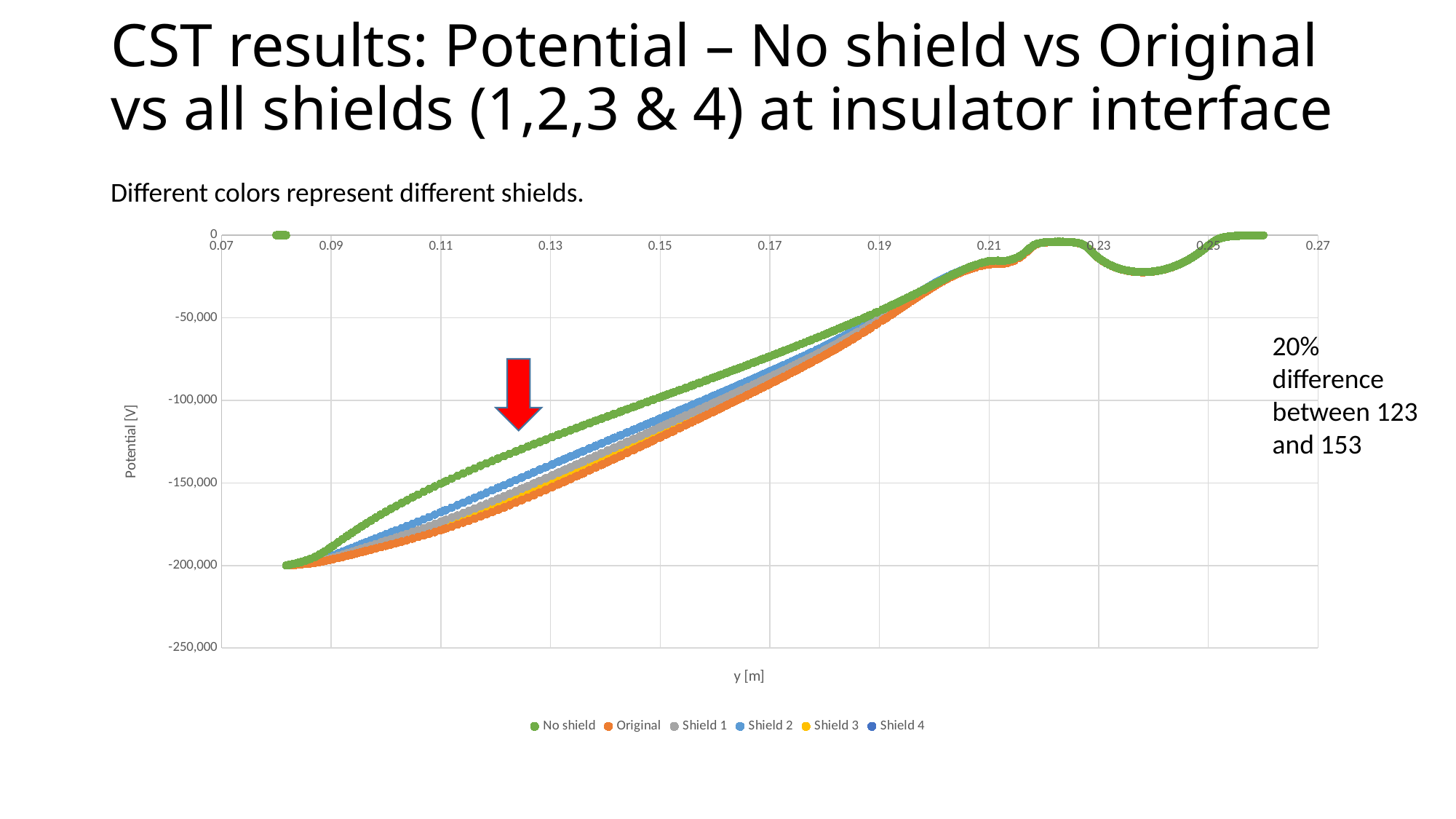
At y = 0.13, which series has the highest potential? No shield At y = 0.13, is the potential for No shield greater or less than -150,000? greater At y = 0.17, is the potential for No shield greater or less than -100,000? greater At y = 0.11, is the potential for Original greater or less than -150,000? less At y = 0.13, which series has the higher potential, No shield or Original? No shield Do the potential values rise or fall as y [m] increases from 0.09 to 0.21? rise What is the label of the vertical axis? Potential [V] How many series does the legend list? 6 What kind of chart is shown on the slide? line chart What is the label of the horizontal axis? y [m]